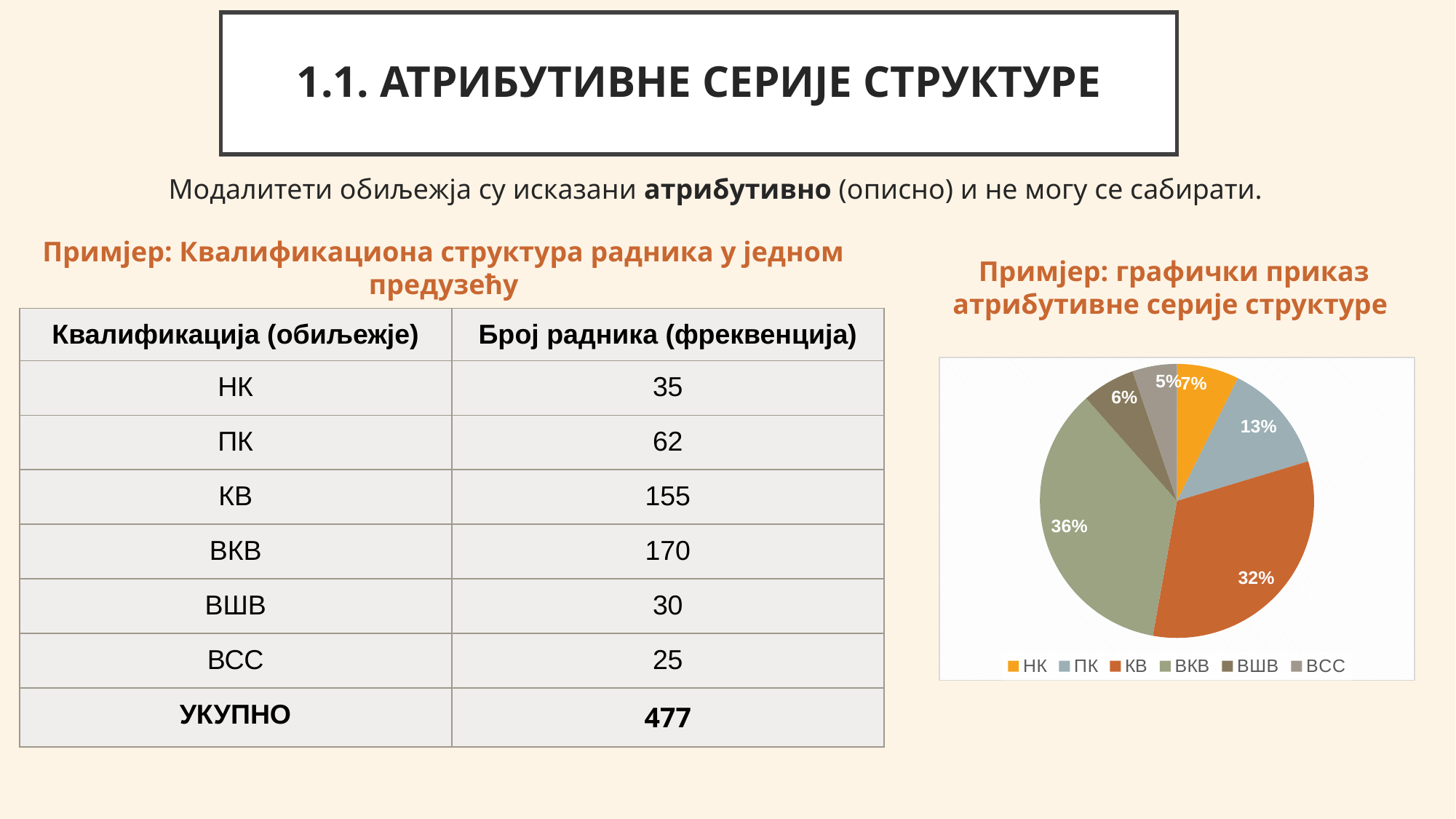
What kind of chart is shown on the slide? pie chart What share of the pie does the ВКВ slice represent? 36% Which category has the smallest slice of the pie? ВСС Which slice is larger, ПК or КВ? КВ How many slices does the pie chart have? 6 What share of the pie does the ВШВ slice represent? 6% What share of the pie does the ПК slice represent? 13% By how many percentage points does the ВКВ slice exceed the КВ slice? 4 Which category has the largest slice of the pie? ВКВ Which category is shown in orange-yellow in the pie chart legend? НК